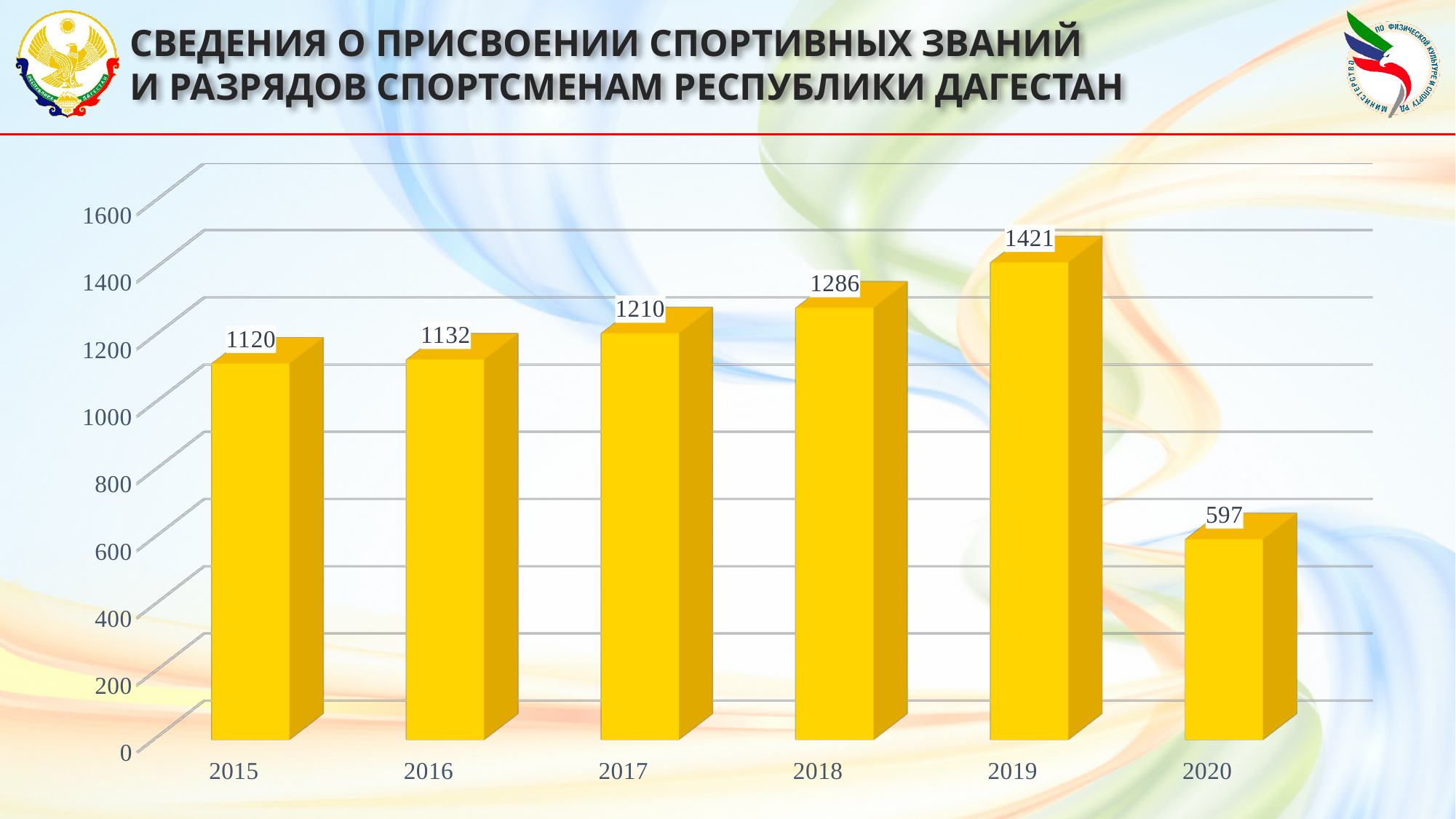
Which year has the lowest value? 2020 Is the value for 2020 greater or less than 800? less What is the value for 2015? 1120 What is the value for 2020? 597 Which is larger, the value for 2016 or the value for 2017? 2017 Which year has the highest value? 2019 What is the value for 2018? 1286 How many years are shown on the x axis? 6 What kind of chart is shown on the slide? bar chart What is the difference between the values for 2017 and 2016? 78 What is the difference between the values for 2019 and 2020? 824 Do the values rise or fall from 2015 to 2019? rise